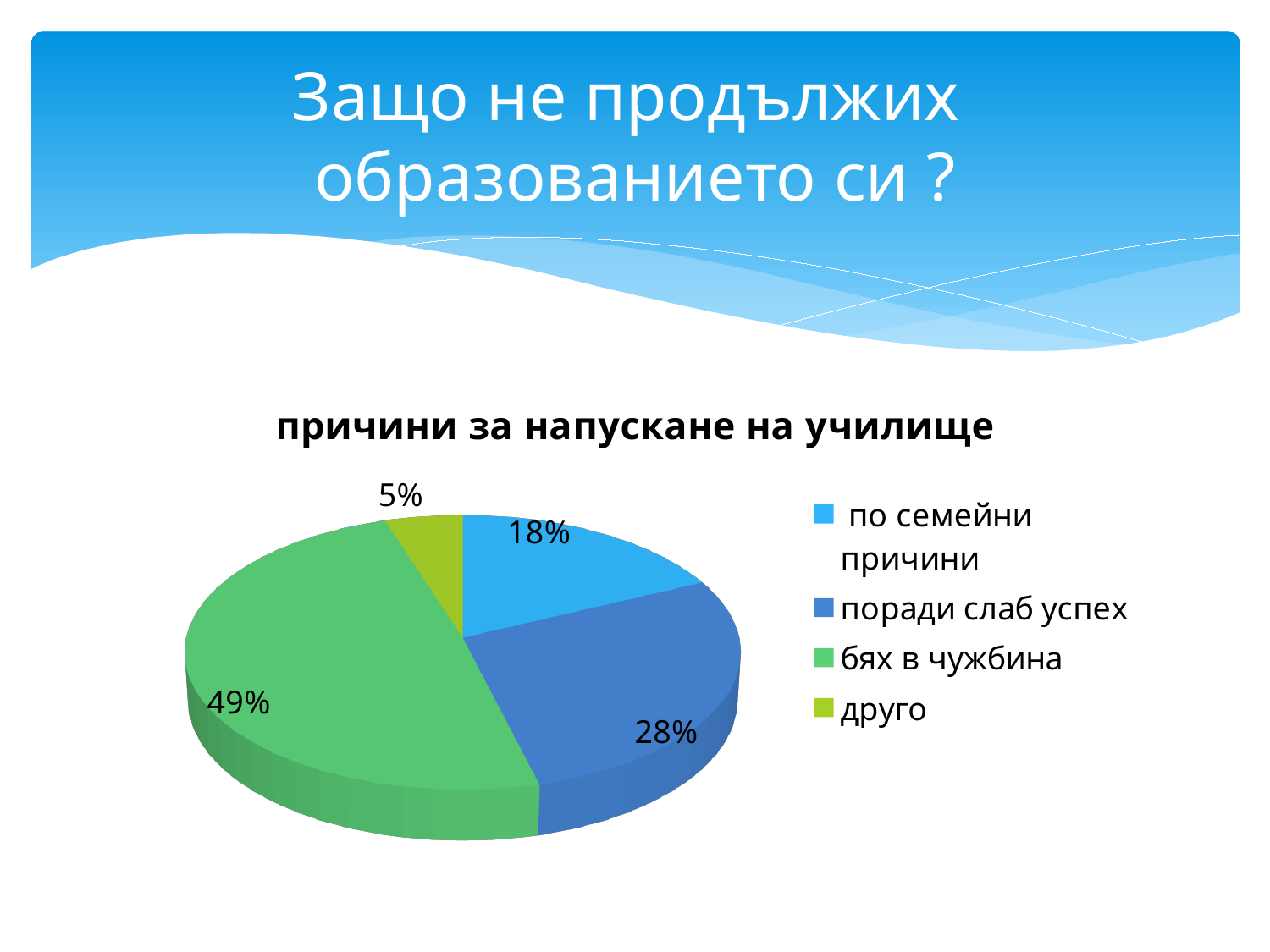
What is the difference in percentage points between 'бях в чужбина' and 'поради слаб успех'? 21 What kind of chart is shown on the slide? pie chart What share of the pie is labelled 'друго'? 5% Which category has the largest share of the pie? бях в чужбина Which is larger, the share for 'по семейни причини' or the share for 'поради слаб успех'? поради слаб успех What colour is the slice for 'друго'? yellow-green What share of the pie is labelled 'бях в чужбина'? 49% What share of the pie is labelled 'поради слаб успех'? 28% Which category has the smallest share of the pie? друго How many categories does the legend list? 4 What is the title of the chart? причини за напускане на училище What share of the pie is labelled 'по семейни причини'? 18%